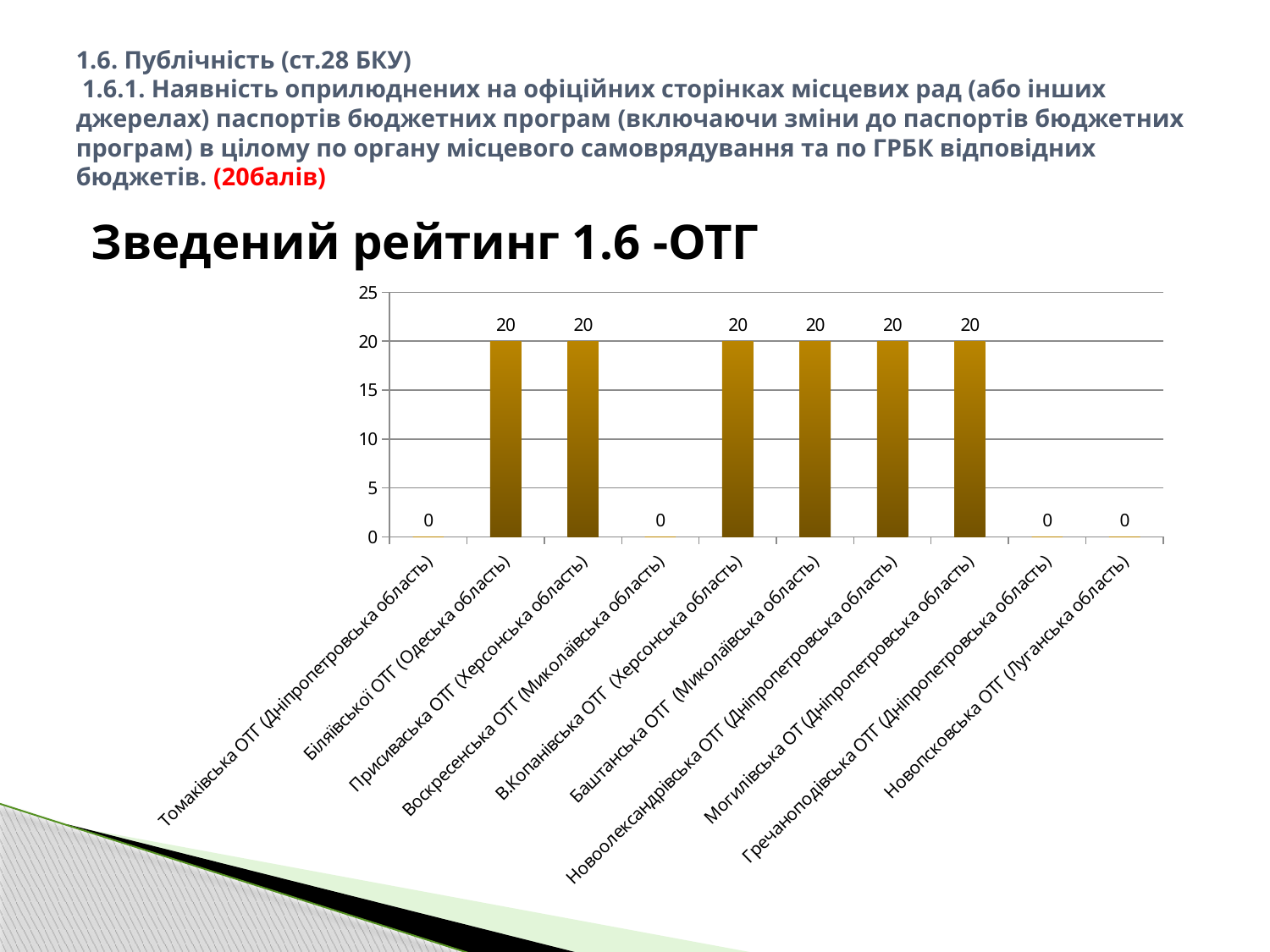
What is the title of the chart? Зведений рейтинг 1.6 -ОТГ Is the value for В.Копанівська ОТГ (Херсонська область) greater or less than 15? greater What is the value for Новопсковська ОТГ (Луганська область)? 0 What is the difference between the values for Присиваська ОТГ (Херсонська область) and Гречаноподівська ОТГ (Дніпропетровська область)? 20 What is the value for Біляївської ОТГ (Одеська область)? 20 What is the value for Воскресенська ОТГ (Миколаївська область)? 0 What is the value for Баштанська ОТГ (Миколаївська область)? 20 How many categories are shown on the x axis of the chart? 10 How many categories have a value of 20? 6 What is the value for Томаківська ОТГ (Дніпропетровська область)? 0 Which has the larger value, Могилівська ОТ (Дніпропетровська область) or Томаківська ОТГ (Дніпропетровська область)? Могилівська ОТ (Дніпропетровська область) What kind of chart is shown on the slide? bar chart